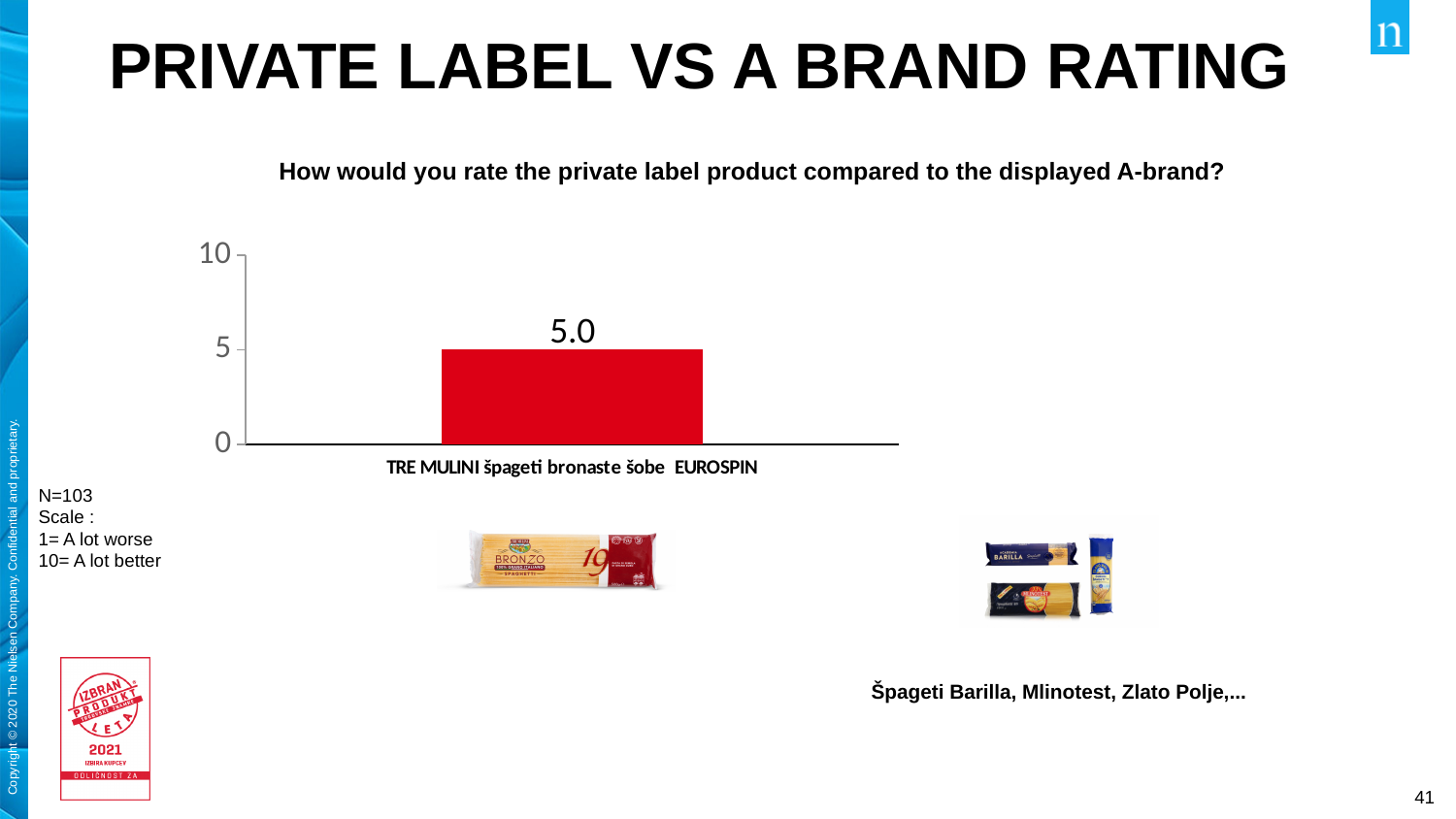
What kind of chart is shown on the slide? bar chart Is the value for TRE MULINI špageti bronaste šobe EUROSPIN greater or less than 0? greater What is the category label under the bar in the chart? TRE MULINI špageti bronaste šobe EUROSPIN How many bars are plotted in the chart? 1 What is the highest value shown on the vertical axis of the chart? 10 What is the value shown for TRE MULINI špageti bronaste šobe EUROSPIN? 5.0 Is the value for TRE MULINI špageti bronaste šobe EUROSPIN greater or less than 10? less